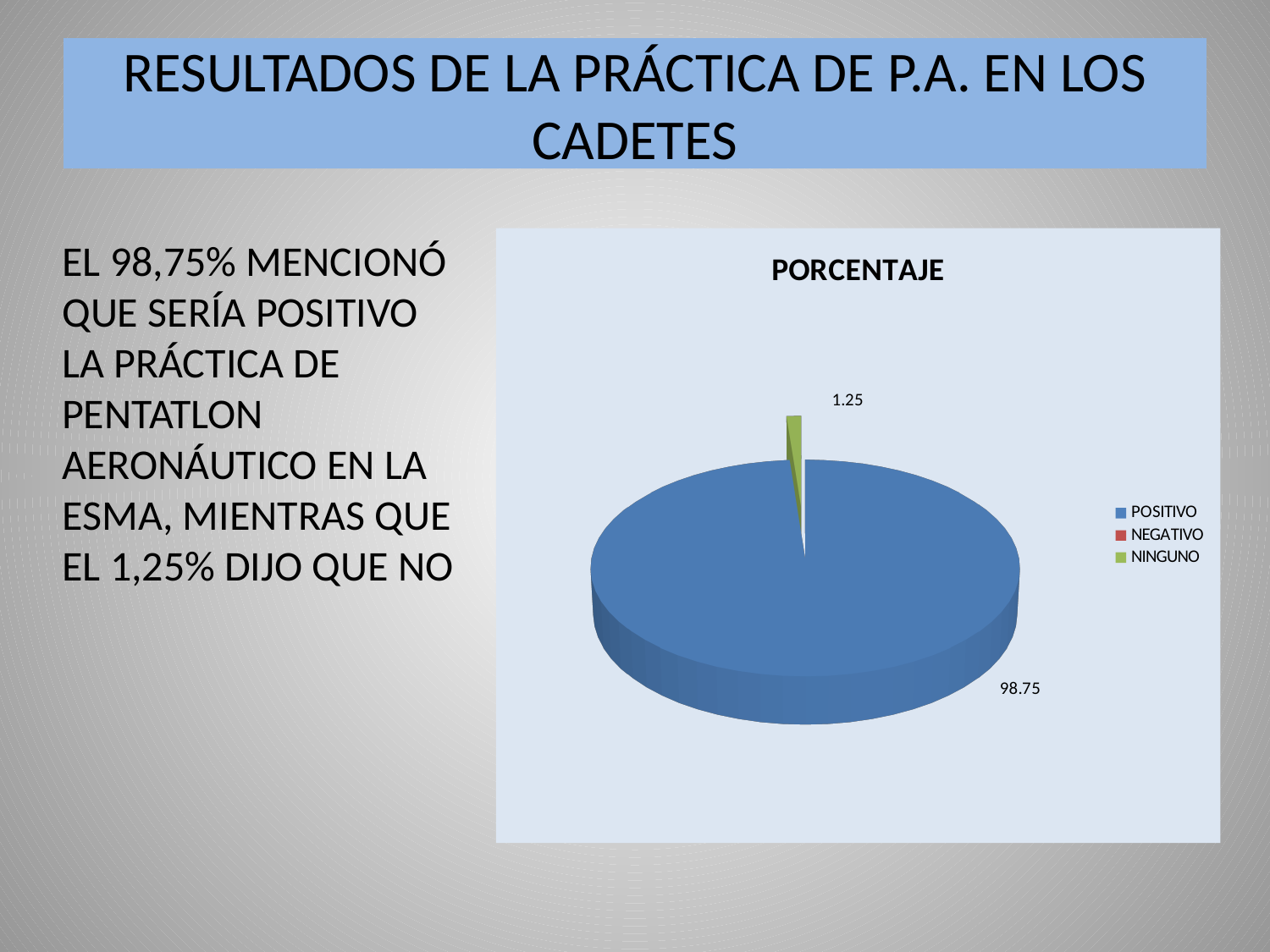
What value is shown for the POSITIVO slice? 98.75 Which legend entry corresponds to the green slice? NINGUNO What value is shown for the NINGUNO slice? 1.25 What kind of chart is shown on the slide? pie chart Which category has the largest slice of the pie? POSITIVO How many entries does the chart's legend list? 3 What is the difference between the POSITIVO value and the NINGUNO value? 97.5 Which is larger, the POSITIVO slice or the NINGUNO slice? POSITIVO What is the title of the chart? PORCENTAJE What colour is used for the POSITIVO slice? blue